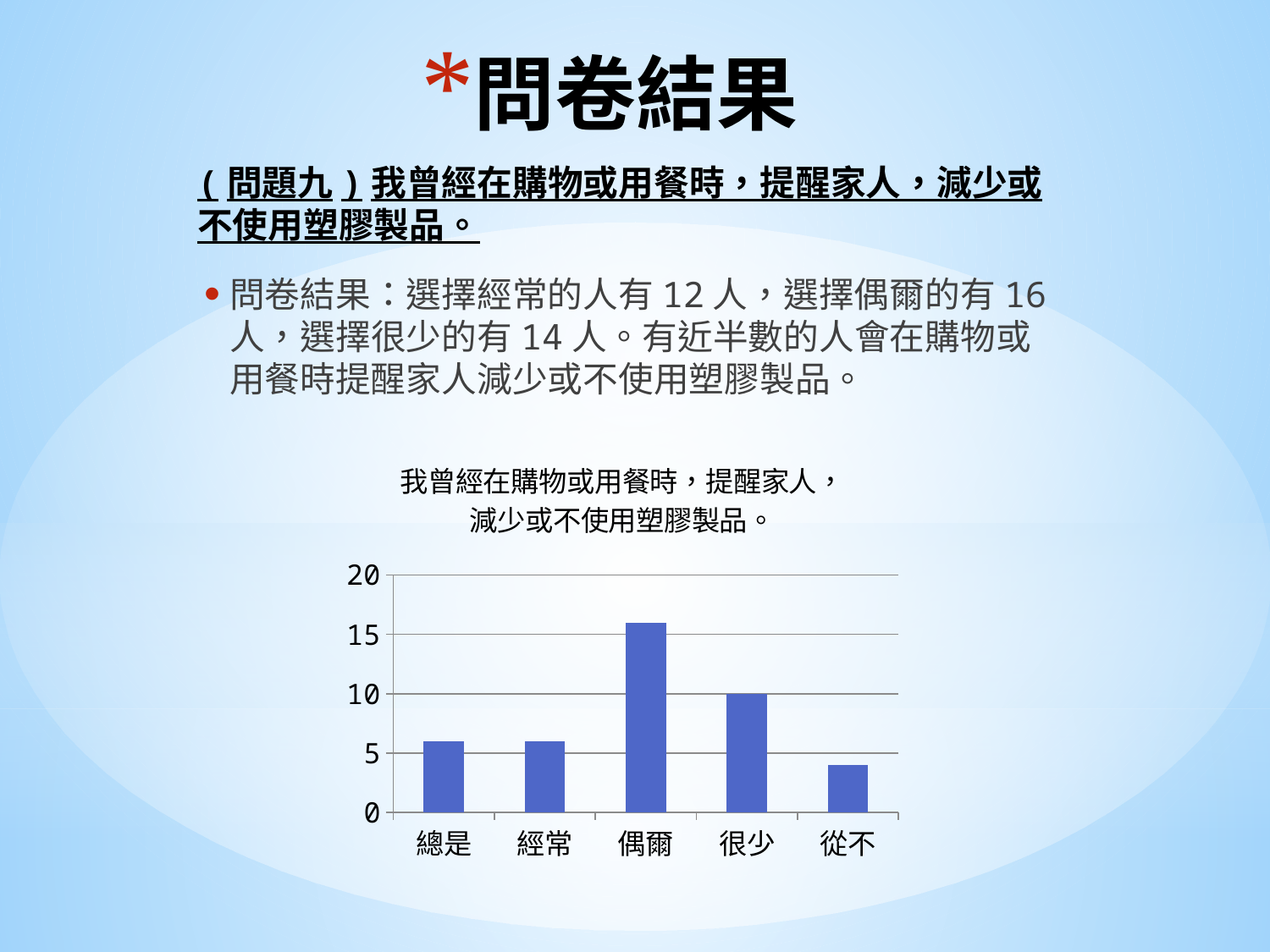
What is the title of the chart? 我曾經在購物或用餐時，提醒家人，減少或不使用塑膠製品。 Is the value for 從不 greater or less than 5? less What is the value for 很少 in the chart? 10 Which is larger, the value for 偶爾 or the value for 很少? 偶爾 Which category has the lowest bar in the chart? 從不 Is the value for 總是 greater or less than 10? less Which category has the highest bar in the chart? 偶爾 Is the value for 偶爾 greater or less than 15? greater What kind of chart is shown on the slide? bar chart Which is larger, the value for 很少 or the value for 從不? 很少 How many categories are shown on the x axis of the chart? 5